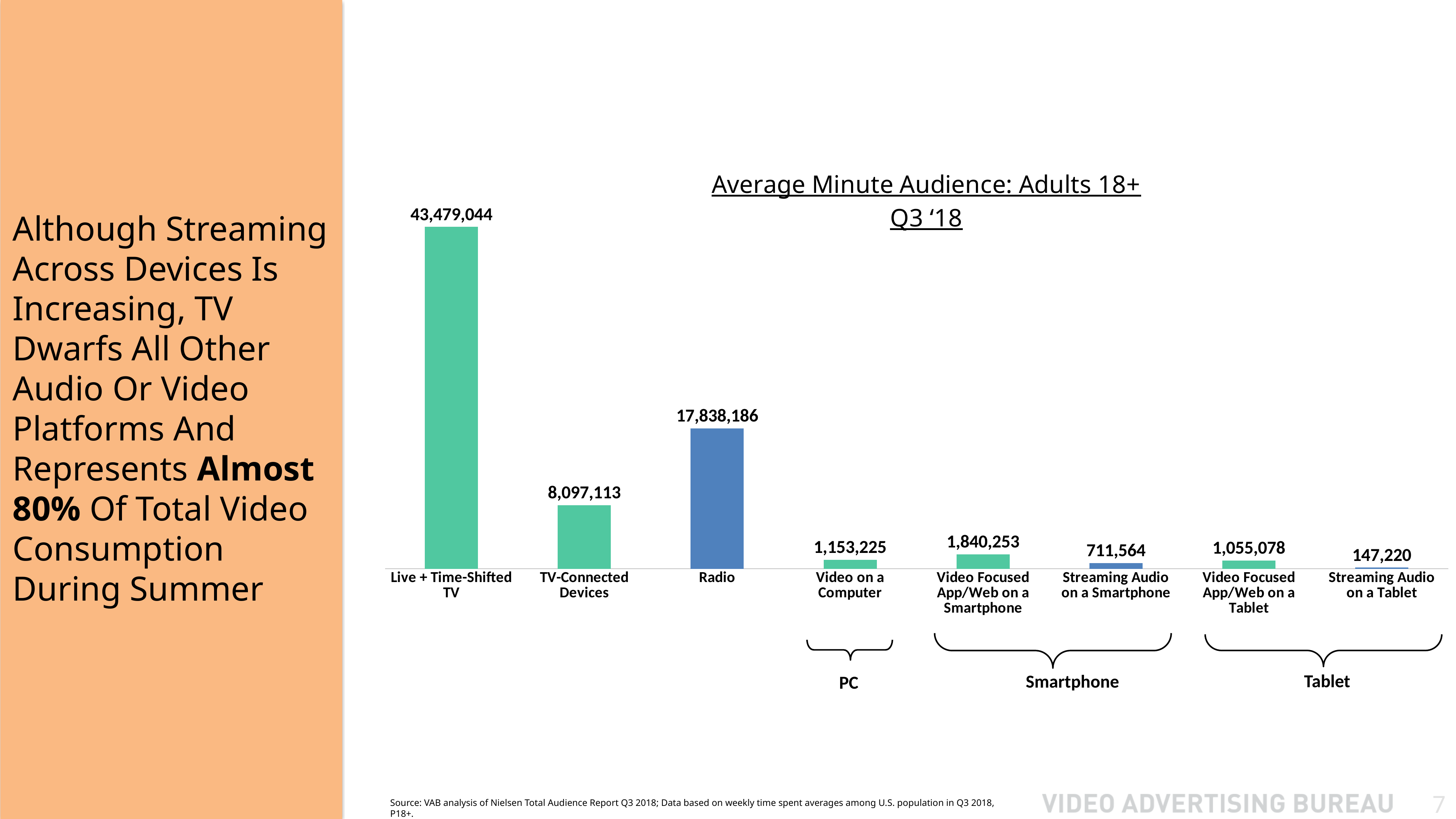
What type of chart is shown on the slide? Bar chart Which category has the lowest average minute audience? Streaming Audio on a Tablet What is the difference between the values for Live + Time-Shifted TV and Radio? 25,640,858 What is the average minute audience for Radio? 17,838,186 What is the value shown for Streaming Audio on a Tablet? 147,220 How many categories are plotted in the chart? 8 Which category has the highest average minute audience? Live + Time-Shifted TV What is the value shown for Video Focused App/Web on a Smartphone? 1,840,253 What is the title of the chart? Average Minute Audience: Adults 18+ Q3 '18 What is the difference between Video Focused App/Web on a Smartphone and Streaming Audio on a Smartphone? 1,128,689 Which is larger: TV-Connected Devices or Video on a Computer? TV-Connected Devices What is the average minute audience for Live + Time-Shifted TV? 43,479,044